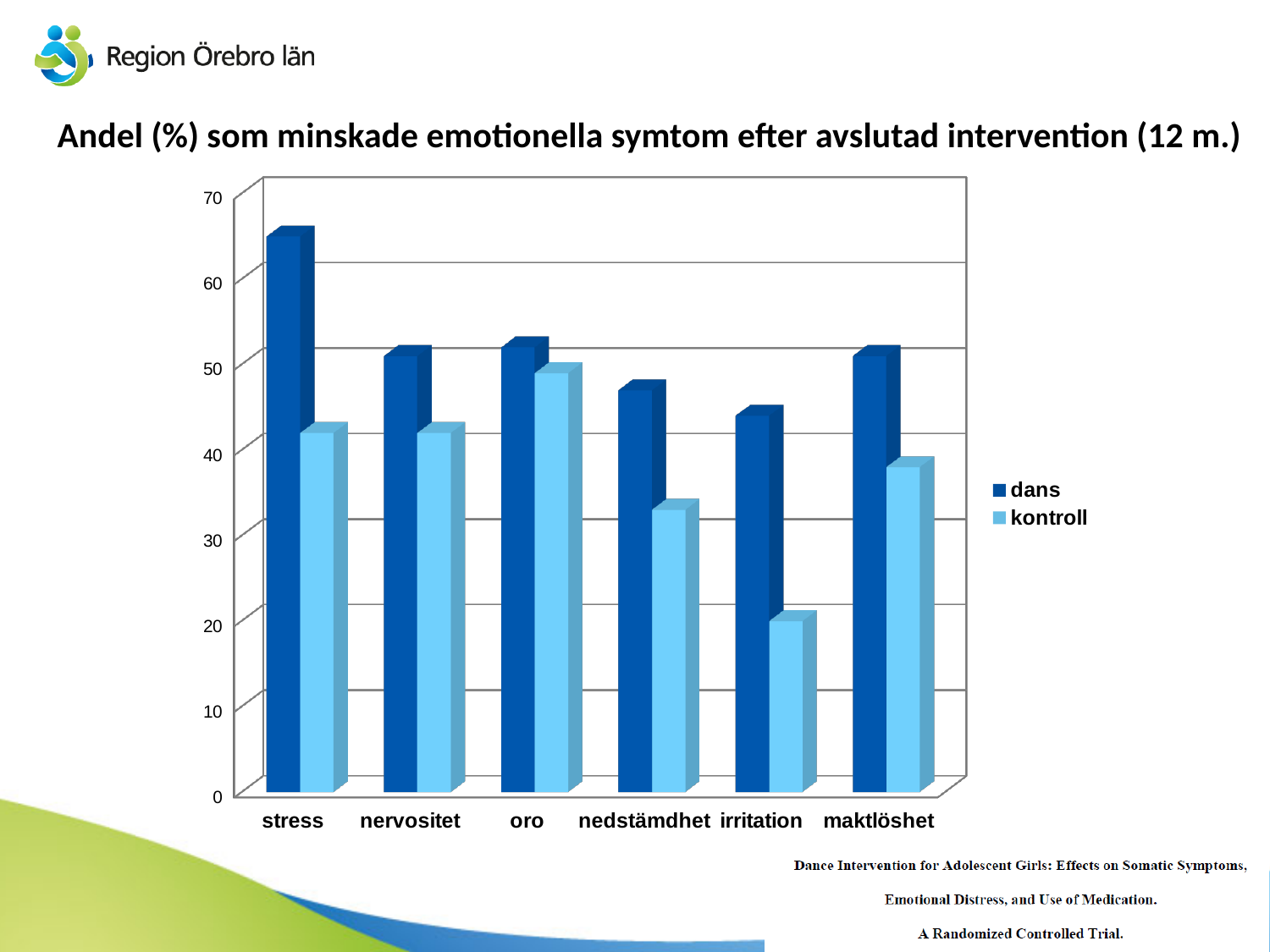
What kind of chart is shown on the slide? bar chart Is the value for kontroll in the irritation category greater or less than 30? less Which category has the highest value for the dans series? stress Is the value for kontroll in the nedstämdhet category greater or less than 40? less Which category has the highest value for the kontroll series? oro For stress, which series has the larger value, dans or kontroll? dans How many series does the legend list? 2 Which category has the lowest value for the kontroll series? irritation How many categories are shown on the x axis of the chart? 6 What are the two series names listed in the legend? dans and kontroll Is the value for dans in the stress category greater or less than 60? greater For irritation, which series has the larger value, dans or kontroll? dans